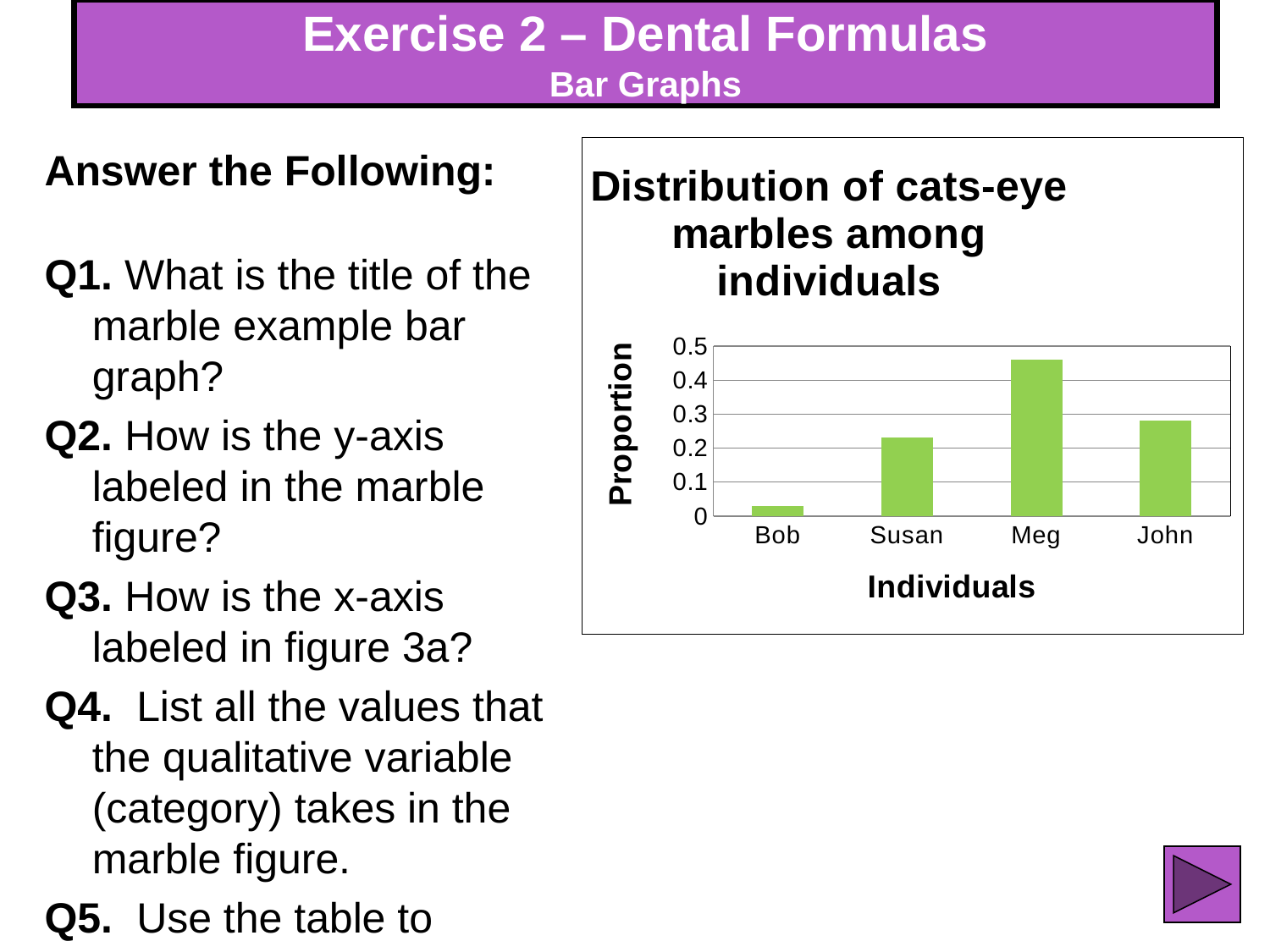
Is the proportion for Bob greater or less than 0.1? less What is the label of the y-axis of the chart? Proportion What is the title of the chart? Distribution of cats-eye marbles among individuals Who has a larger proportion, John or Susan? John Which individual has the highest proportion of cats-eye marbles? Meg Who has a larger proportion, Susan or Meg? Meg What kind of chart is shown on the slide? bar chart How many individuals are shown on the x-axis of the chart? 4 Is the proportion for Meg greater or less than 0.4? greater Which individual has the lowest proportion of cats-eye marbles? Bob Is the proportion for Susan greater or less than 0.2? greater